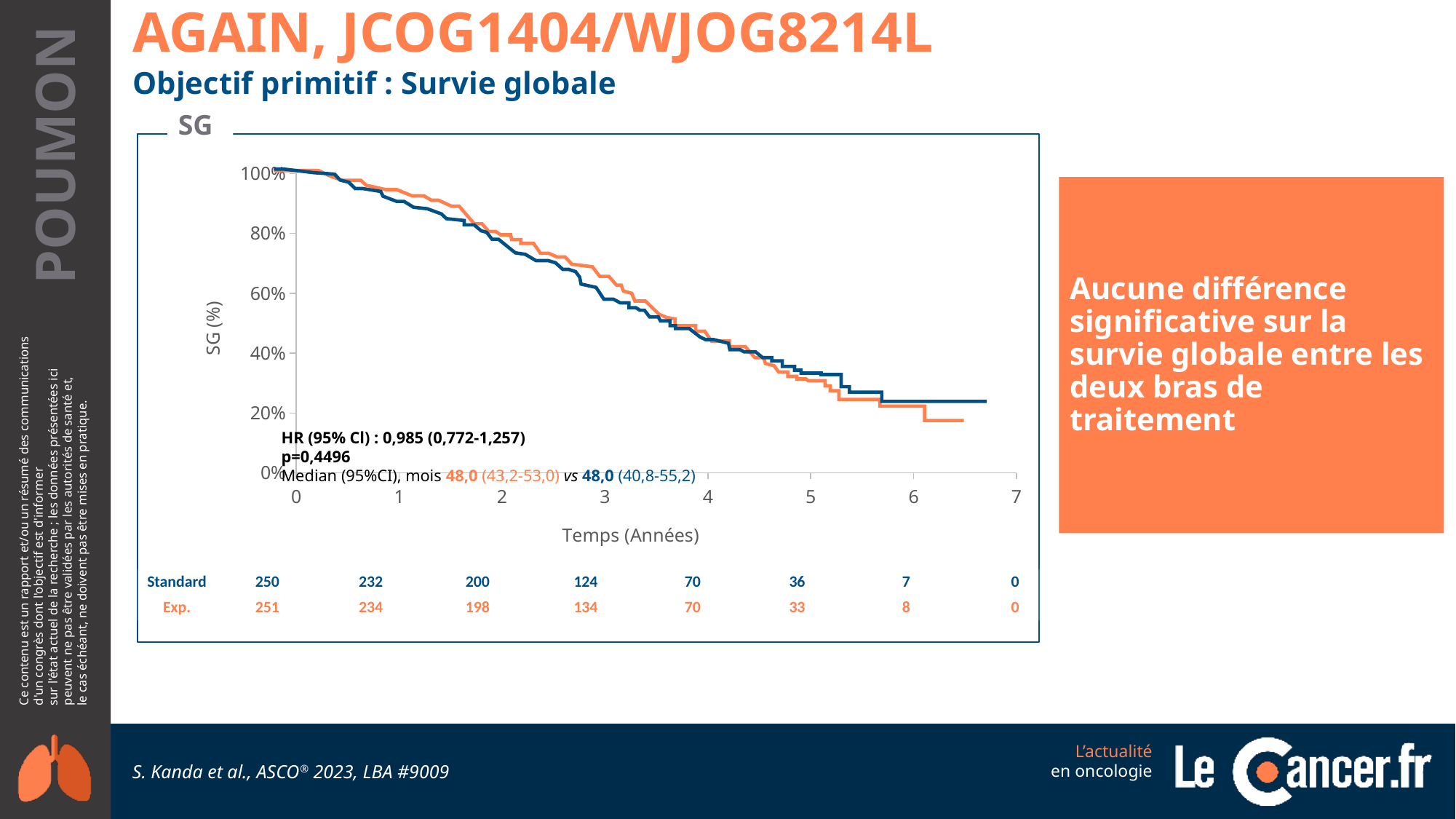
What is the p-value reported on the chart? p=0,4496 How many treatment arms (series) are plotted on the survival chart? 2 How many patients were at risk in the Exp. arm at year 6? 8 Do the survival curves rise or fall as time increases along the x axis? fall What is the median overall survival in months for the Standard arm? 48,0 How many patients were at risk in the Exp. arm at year 3? 134 What is the difference in the number at risk at year 3 between the Exp. arm and the Standard arm? 10 At year 2, which arm had more patients at risk, Standard or Exp.? Standard How many patients were at risk in the Standard arm at time 0? 250 What is the hazard ratio (HR) reported on the chart? 0,985 Is the Standard arm survival at year 5 greater or less than 40%? less What kind of chart is shown on the slide? line chart